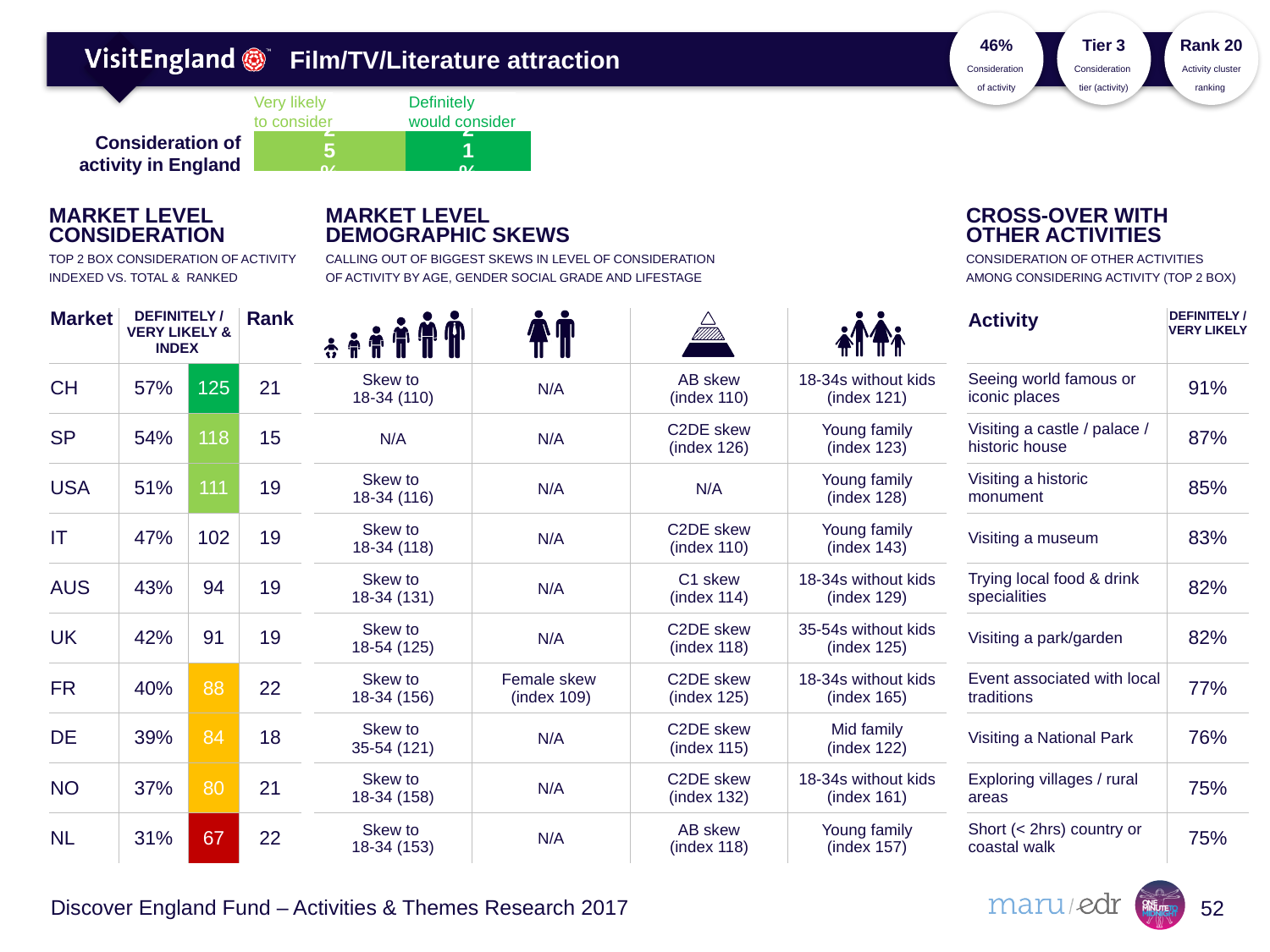
What is the total consideration of the activity shown on the slide (the combined 'Very likely' and 'Definitely' figure)? 46% In the 'Consideration of activity in England' chart, which segment is shown in the darker green colour? Definitely would consider How many series does the legend of the 'Consideration of activity in England' chart list? 2 How many bars are plotted in the 'Consideration of activity in England' chart? 1 What are the two legend entries of the 'Consideration of activity in England' chart? Very likely to consider; Definitely would consider In the 'Consideration of activity in England' chart, which segment is larger: 'Very likely to consider' or 'Definitely would consider'? Very likely to consider What kind of chart is shown under the 'Consideration of activity in England' label? A stacked bar chart